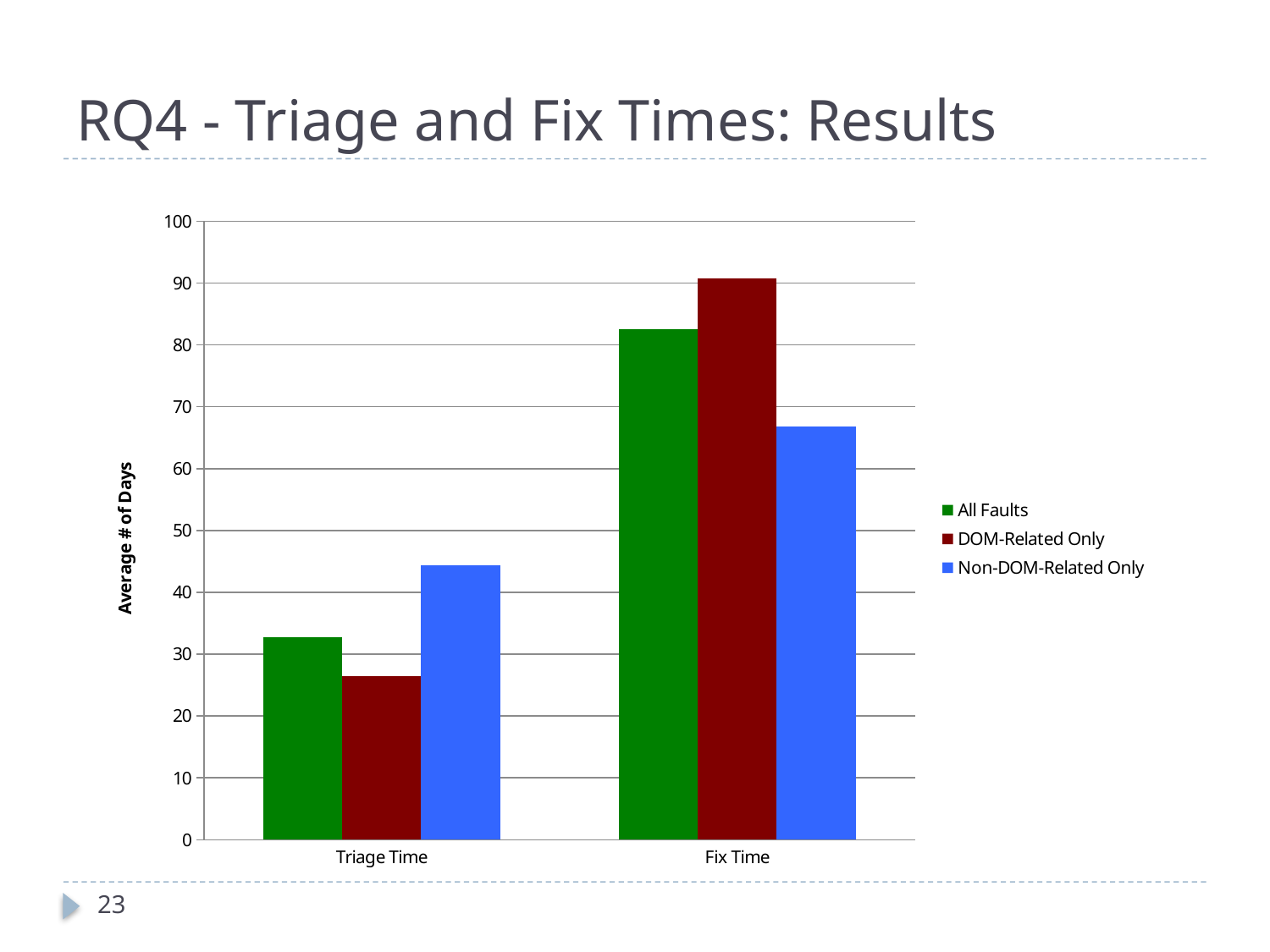
For All Faults, which is larger: Triage Time or Fix Time? Fix Time How many categories are shown on the x axis? 2 What kind of chart is shown on the slide? bar chart What is the label on the vertical axis? Average # of Days Which series has the highest value for Fix Time? DOM-Related Only Is the Fix Time value for Non-DOM-Related Only greater or less than 60? greater How many series does the legend list? 3 Which series has the highest value for Triage Time? Non-DOM-Related Only Which series has the lowest value for Fix Time? Non-DOM-Related Only Is the Triage Time value for All Faults greater or less than 40? less Which series has the lowest value for Triage Time? DOM-Related Only